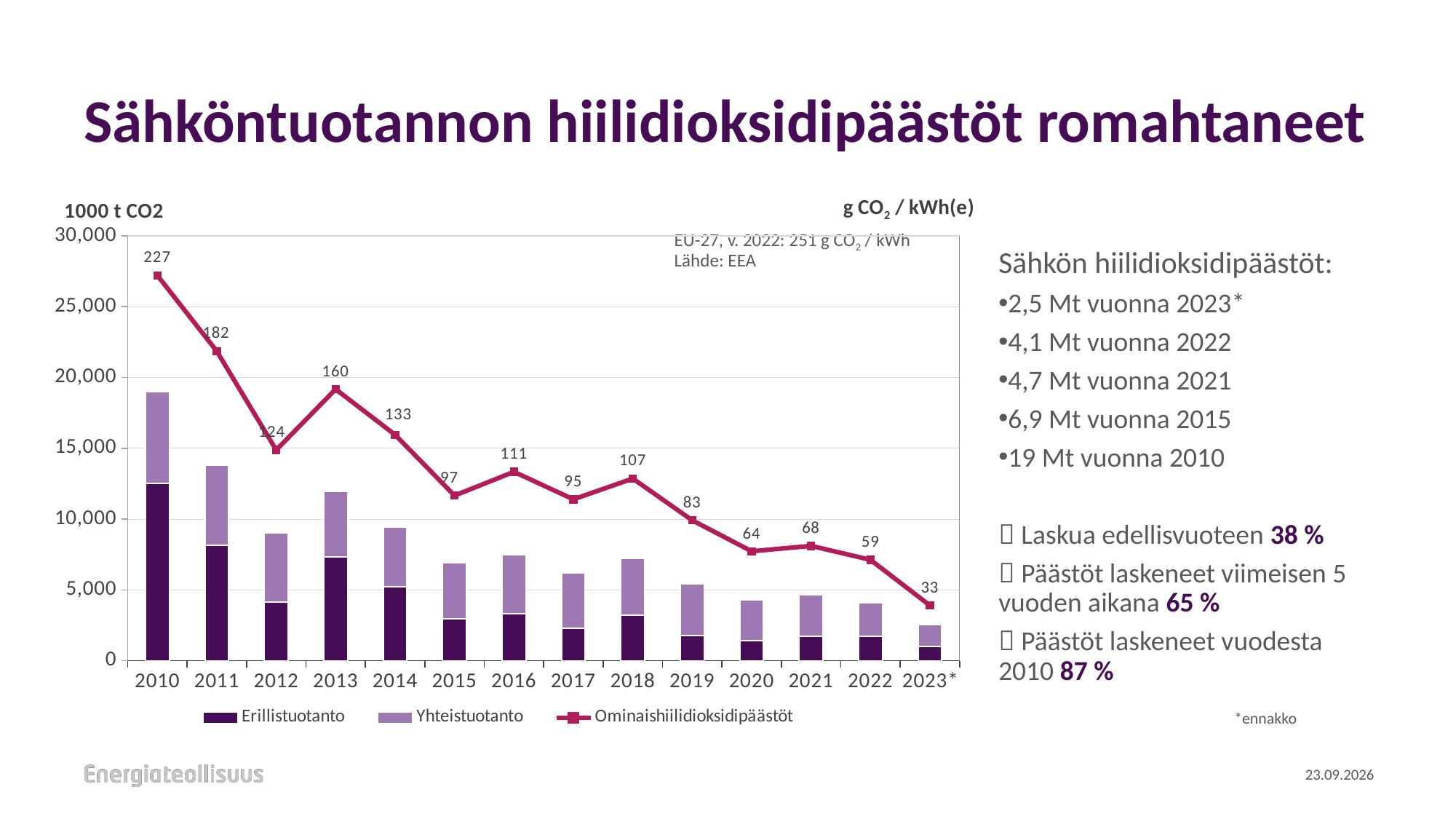
Which year has the lowest Ominaishiilidioksidipäästöt value? 2023 What is the Ominaishiilidioksidipäästöt value for 2010? 227 What is the Ominaishiilidioksidipäästöt value for 2016? 111 Which year has the highest Ominaishiilidioksidipäästöt value? 2010 What is the Ominaishiilidioksidipäästöt value for 2023? 33 Which is larger, the Ominaishiilidioksidipäästöt value for 2020 or for 2021? 2021 How many series does the legend list? 3 Is the total stacked bar value for 2023 greater or less than 5,000? less How many years are shown on the x axis? 14 What is the overall trend of the Ominaishiilidioksidipäästöt line from 2010 to 2023? falling Is the total stacked bar value for 2010 greater or less than 15,000? greater What is the difference between the Ominaishiilidioksidipäästöt values for 2012 and 2013? 36